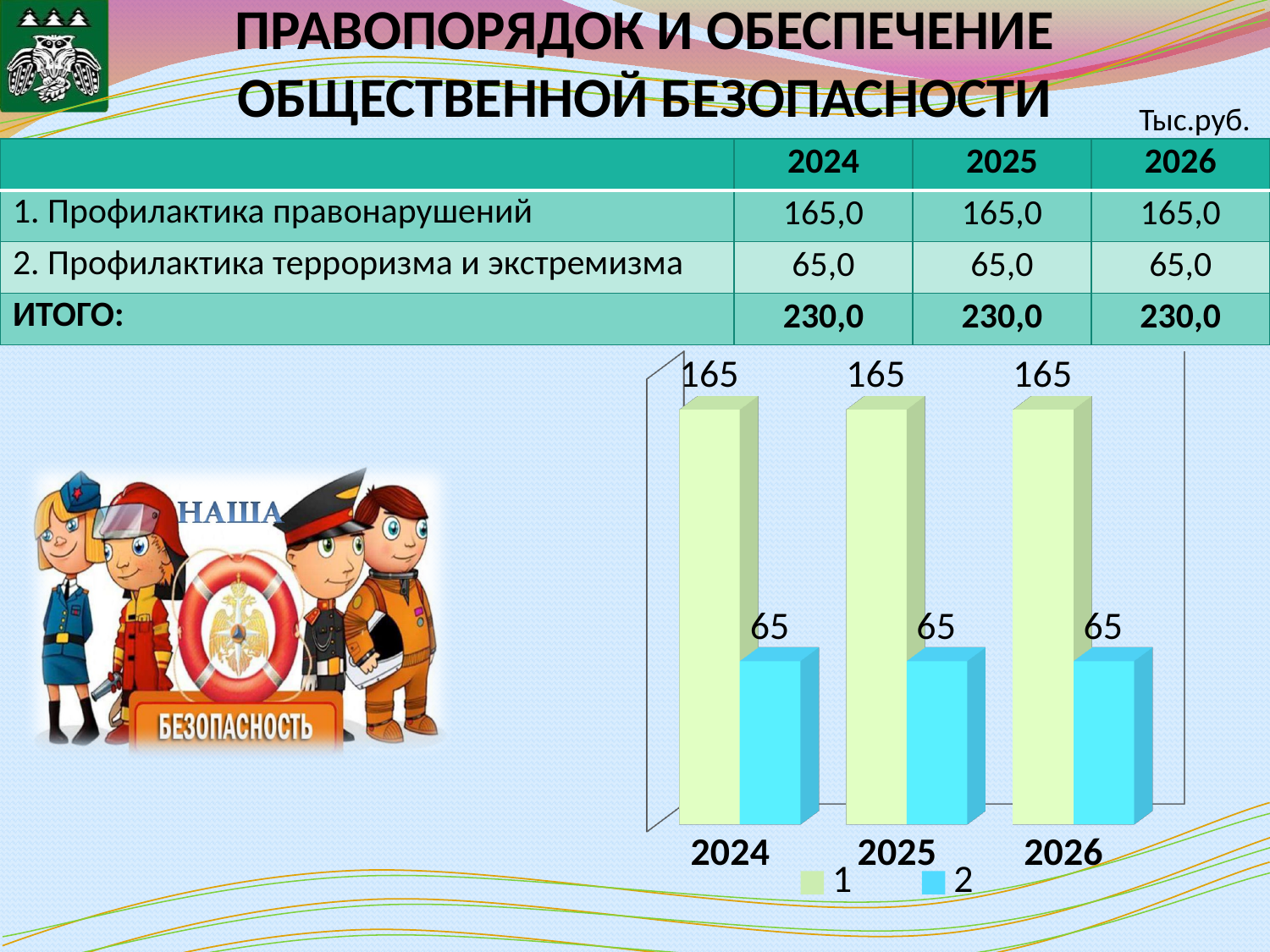
What kind of chart is shown on the slide? bar chart Which year categories are labelled on the x axis of the chart? 2024, 2025, 2026 What is the combined value of series 1 and series 2 for 2024 in the chart? 230 What colour are the bars for series 2 in the chart? blue What is the difference between series 1 and series 2 for 2025 in the chart? 100 What is the value of series 2 for 2026 in the chart? 65 Which series has the larger value for 2026 in the chart, series 1 or series 2? 1 How many series does the chart legend list? 2 What is the value of series 2 for 2025 in the chart? 65 How many year categories are shown on the x axis of the chart? 3 What is the value of series 1 for 2024 in the chart? 165 Do the values of series 1 rise, fall or stay the same from 2024 to 2026 in the chart? stay the same